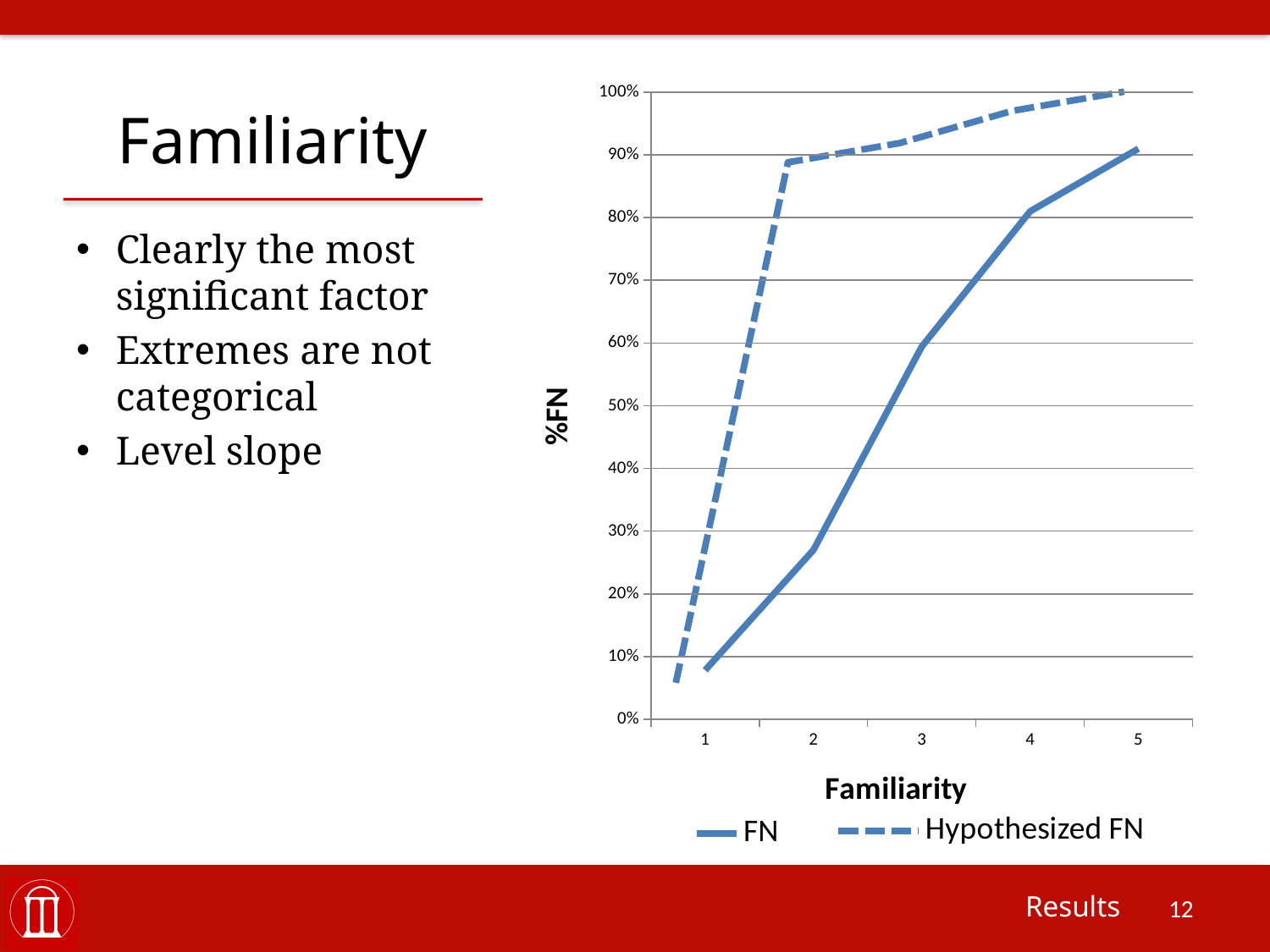
Which series is drawn with a dashed line? Hypothesized FN Is the FN value at familiarity 5 greater or less than 80%? greater At familiarity 2, which series has the larger value, FN or Hypothesized FN? Hypothesized FN How many series does the chart's legend list? 2 Is the FN value at familiarity 3 greater or less than 50%? greater What kind of chart is shown on the slide? line chart Is the FN value at familiarity 1 greater or less than 10%? less How many familiarity levels are plotted along the x axis? 5 Do the FN values rise or fall as familiarity increases from 1 to 5? rise What is the title of the chart's x axis? Familiarity